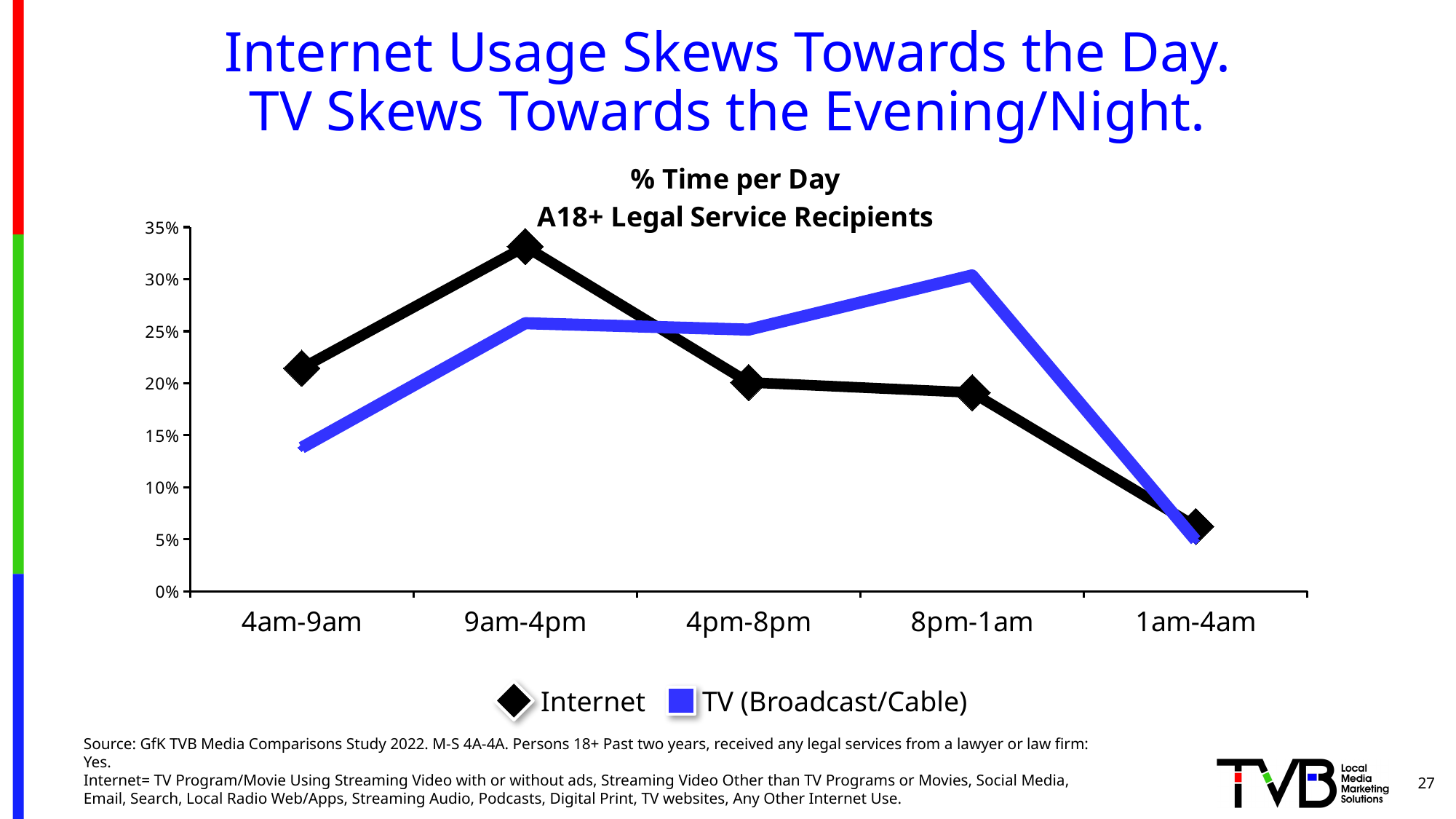
What is the title of the chart? % Time per Day A18+ Legal Service Recipients In which time period is the Internet series lowest? 1am-4am Which series has the larger value for 4am-9am, Internet or TV (Broadcast/Cable)? Internet Does the TV (Broadcast/Cable) series rise or fall from 4pm-8pm to 8pm-1am? Rise In which time period is the TV (Broadcast/Cable) series highest? 8pm-1am Which series has the larger value for 8pm-1am, Internet or TV (Broadcast/Cable)? TV (Broadcast/Cable) Is the TV (Broadcast/Cable) value for 4am-9am greater or less than 15%? less In which time period is the Internet series highest? 9am-4pm How many series does the legend list? 2 How many time periods are shown on the x axis? 5 What kind of chart is shown on the slide? Line chart Is the Internet value for 9am-4pm greater or less than 30%? greater